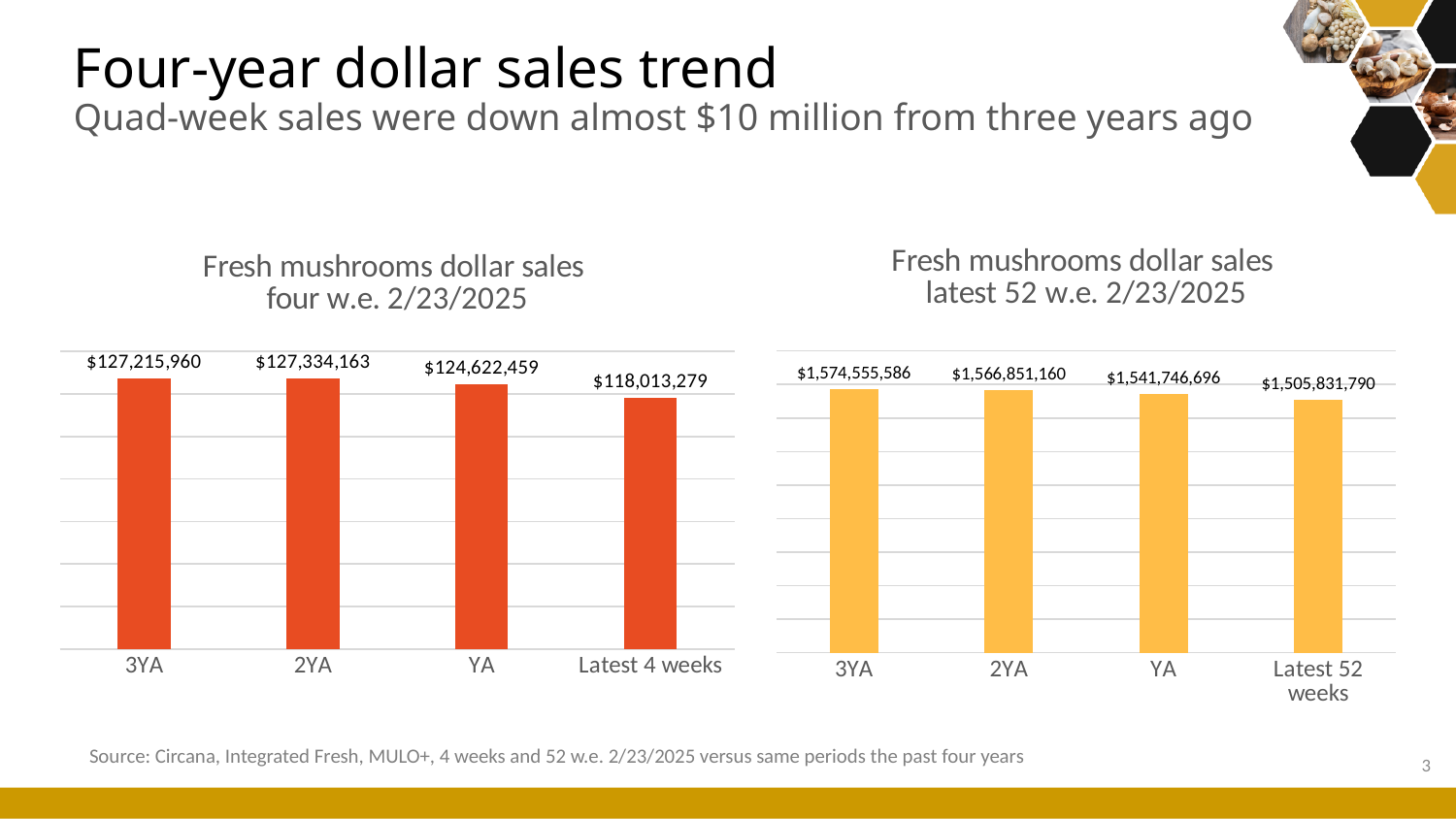
In the 'Fresh mushrooms dollar sales four w.e. 2/23/2025' chart, what is the difference between the 3YA value and the Latest 4 weeks value? $9,202,681 In the 'Fresh mushrooms dollar sales latest 52 w.e. 2/23/2025' chart, what is the value for Latest 52 weeks? $1,505,831,790 In the 'Fresh mushrooms dollar sales four w.e. 2/23/2025' chart, what is the value for 3YA? $127,215,960 In the 'Fresh mushrooms dollar sales latest 52 w.e. 2/23/2025' chart, what is the value for YA? $1,541,746,696 In the 'Fresh mushrooms dollar sales four w.e. 2/23/2025' chart, which category has the lowest value? Latest 4 weeks In the 'Fresh mushrooms dollar sales latest 52 w.e. 2/23/2025' chart, what is the difference between the 3YA value and the Latest 52 weeks value? $68,723,796 In the 'Fresh mushrooms dollar sales latest 52 w.e. 2/23/2025' chart, do the values rise or fall from 3YA to Latest 52 weeks? Fall In the 'Fresh mushrooms dollar sales latest 52 w.e. 2/23/2025' chart, which category has the highest value? 3YA What kind of chart is the 'Fresh mushrooms dollar sales latest 52 w.e. 2/23/2025' chart? Bar chart In the 'Fresh mushrooms dollar sales four w.e. 2/23/2025' chart, what is the value for Latest 4 weeks? $118,013,279 How many categories are shown in the 'Fresh mushrooms dollar sales four w.e. 2/23/2025' chart? 4 In the 'Fresh mushrooms dollar sales latest 52 w.e. 2/23/2025' chart, which is larger, the value for 2YA or the value for Latest 52 weeks? 2YA